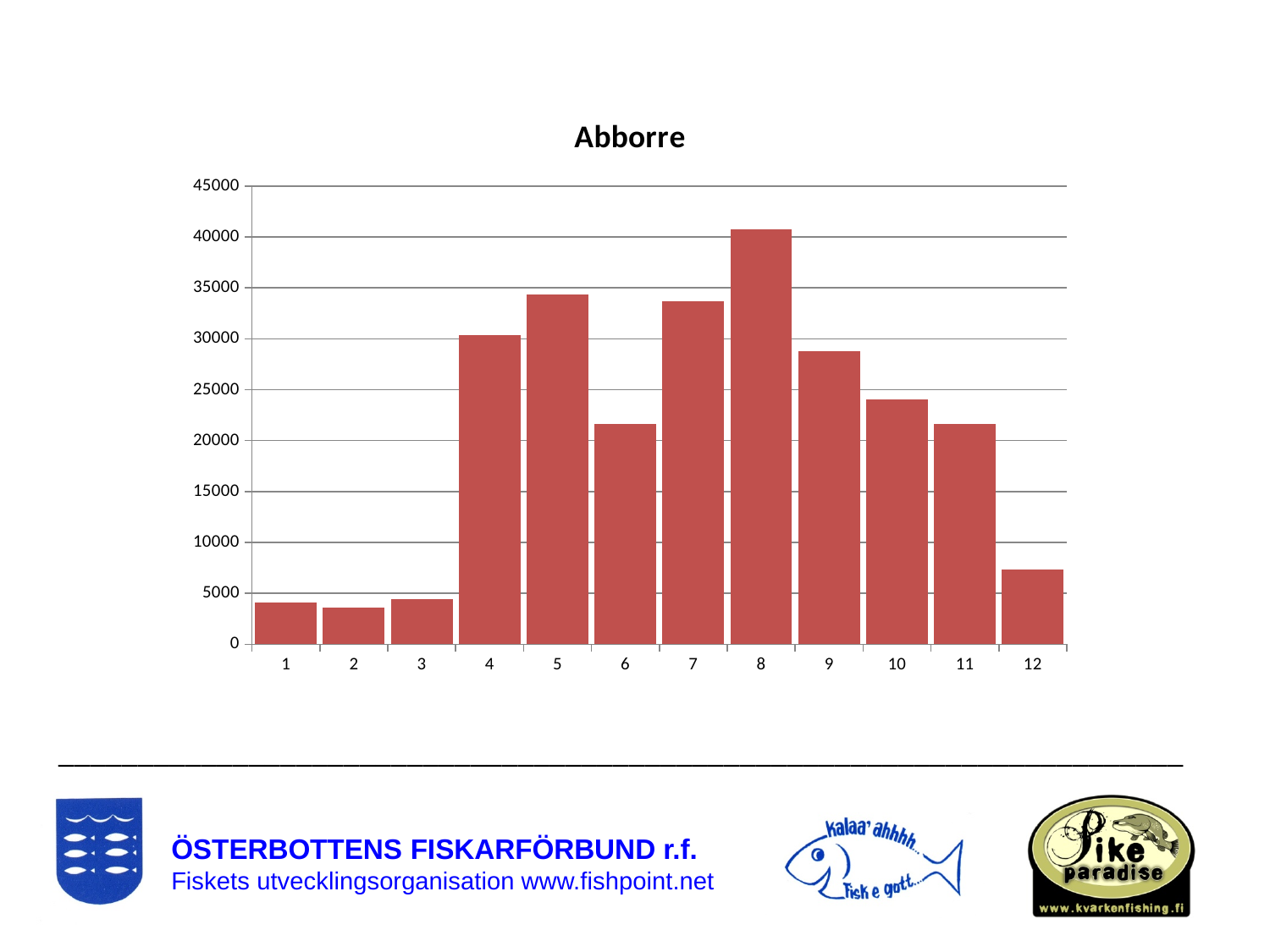
Is the value for category 6 greater or less than 20000? greater Is the value for category 12 greater or less than 5000? greater From category 8 to category 12, do the values rise or fall? fall What kind of chart is shown on the slide? bar chart Which has the larger value, category 9 or category 10? 9 Which category has the highest value in the chart? 8 Is the value for category 1 greater or less than 5000? less How many categories are shown on the x axis of the chart? 12 What is the title of the chart? Abborre Which has the larger value, category 3 or category 12? 12